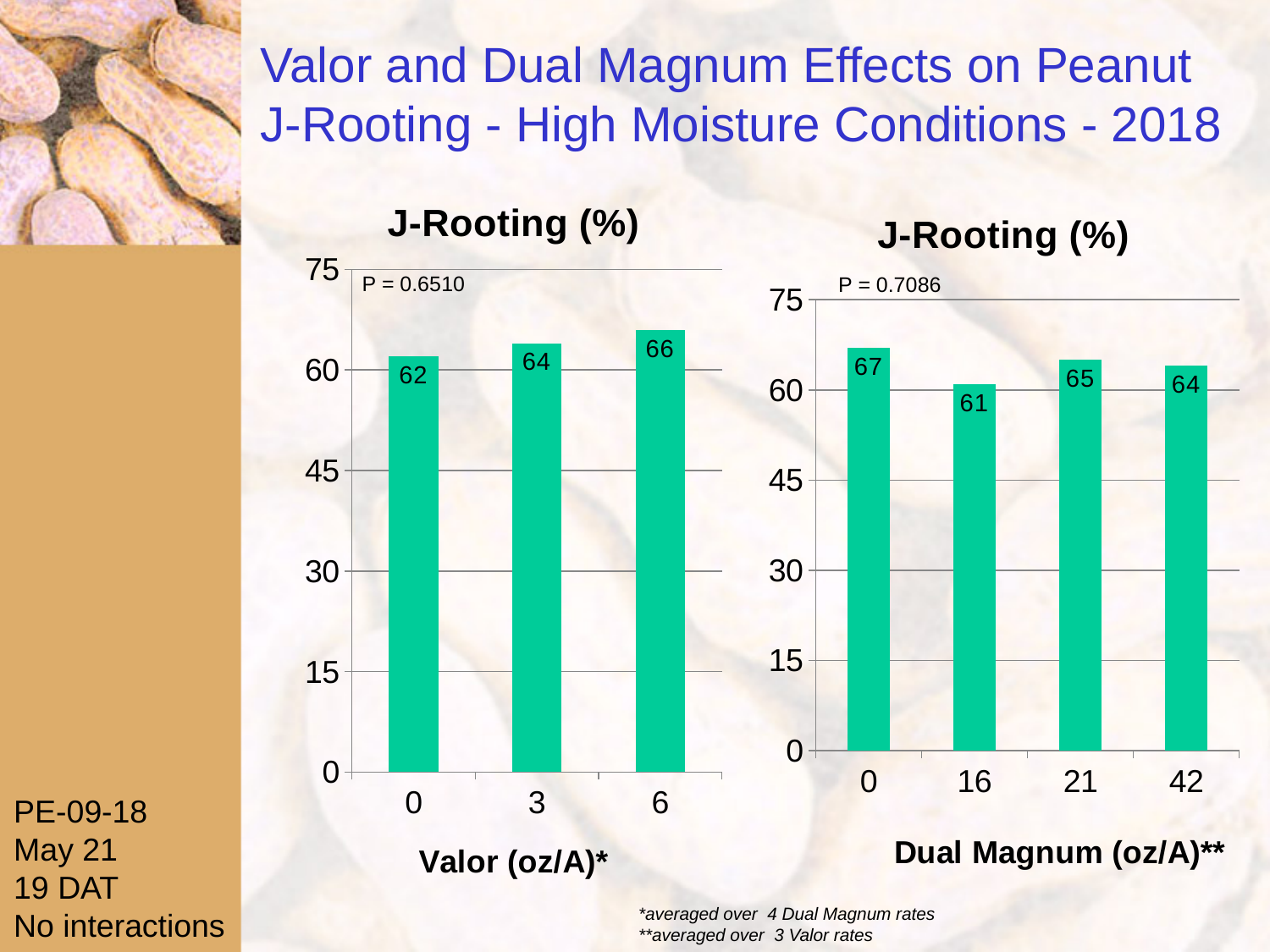
In the right chart (Dual Magnum), which Dual Magnum rate has the highest J-Rooting value? 0 In the right chart (Dual Magnum), which Dual Magnum rate has the lowest J-Rooting value? 16 In the right chart (Dual Magnum), what is the J-Rooting value at 16 oz/A? 61 In the right chart (Dual Magnum), what is the difference between the J-Rooting values at 0 oz/A and 16 oz/A? 6 In the left chart (Valor), do the J-Rooting values rise or fall as the Valor rate increases? rise In the right chart (Dual Magnum), which has the larger J-Rooting value: 21 oz/A or 42 oz/A? 21 oz/A How many Valor rates are plotted in the left chart? 3 How many Dual Magnum rates are plotted in the right chart? 4 In the left chart (Valor), what is the difference between the J-Rooting values at 6 oz/A and 0 oz/A? 4 What type of chart is the left chart (Valor)? bar chart In the left chart (Valor), which Valor rate has the highest J-Rooting value? 6 In the left chart (Valor), what is the J-Rooting value at 3 oz/A? 64